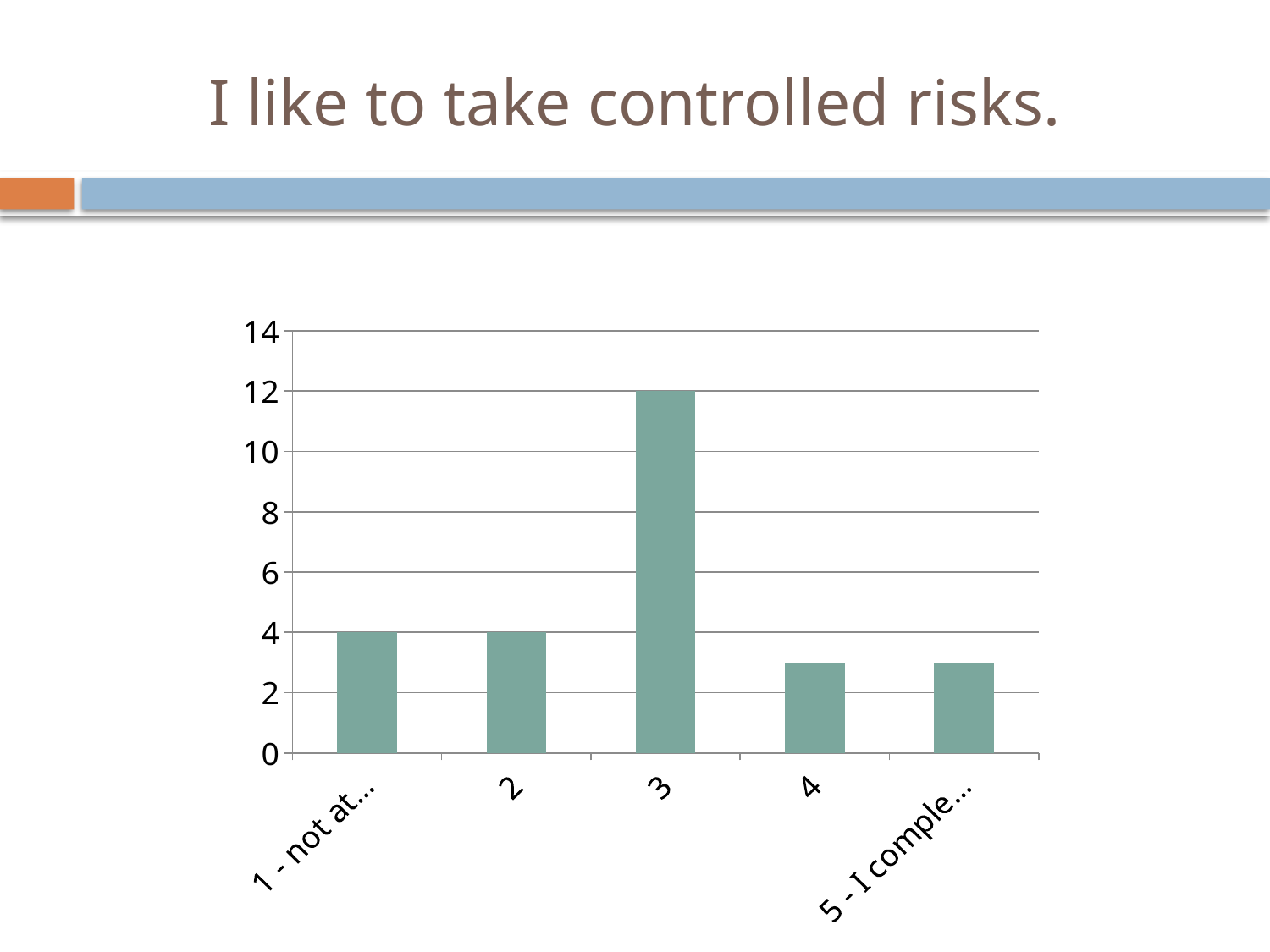
Which is larger, the value for category 3 or the value for category 2? 3 How many categories are shown on the x axis? 5 Which category has the highest value? 3 What is the value for category 3? 12 What is the difference between the values for category 3 and category 2? 8 Which is larger, the value for category 2 or the value for category 4? 2 What kind of chart is shown on the slide? bar chart Is the value for the category labelled "5 - I comple..." greater or less than 2? greater What is the value for the category labelled "1 - not at..."? 4 What is the title of the slide? I like to take controlled risks. What is the value for category 2? 4 Is the value for category 4 greater or less than 4? less